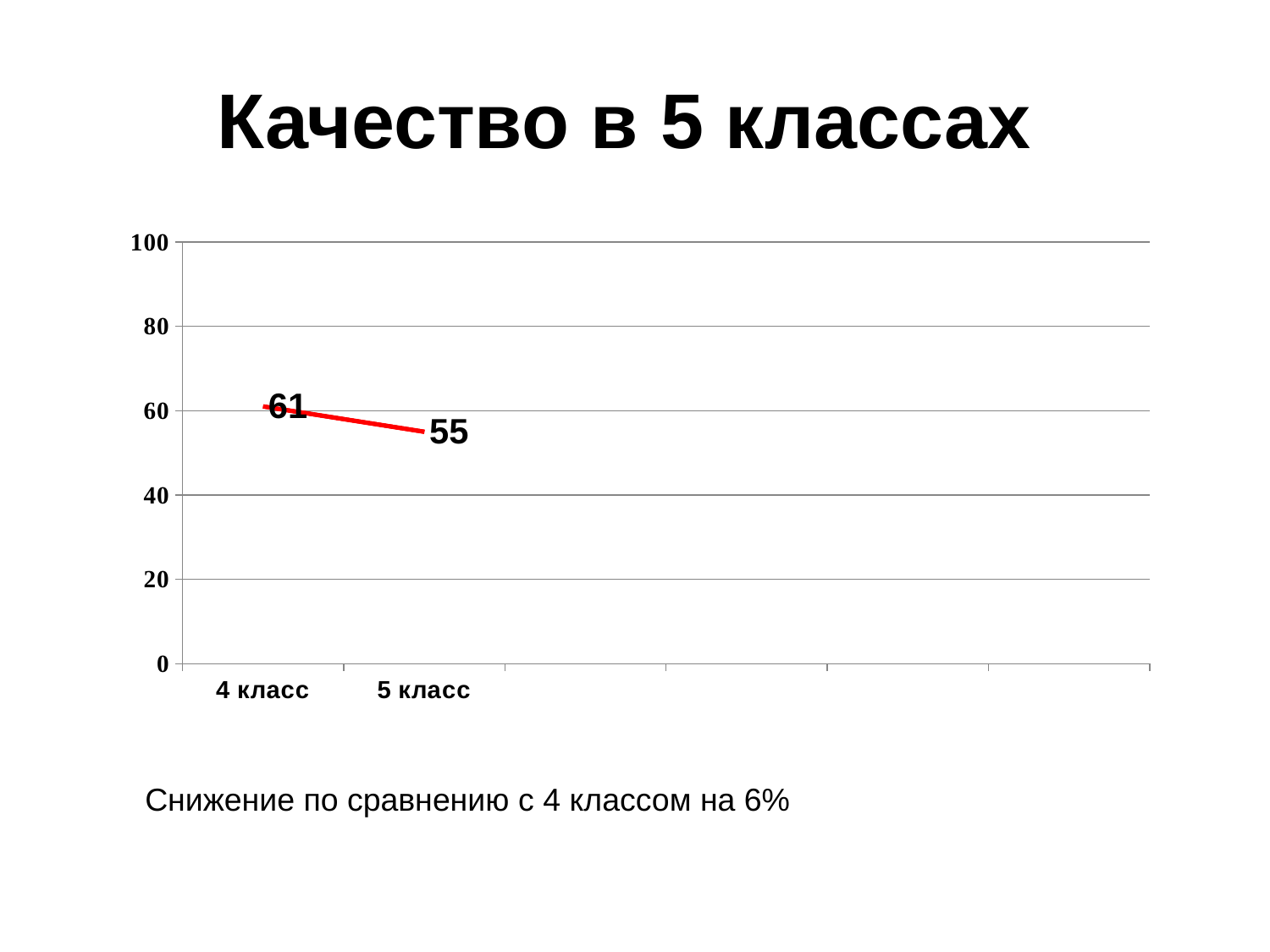
What is the value for 5 класс? 55 Which category has the highest value? 4 класс What is the difference between the values for 4 класс and 5 класс? 6 What is the value for 4 класс? 61 Is the value for 5 класс greater or less than 60? less Do the values rise or fall from 4 класс to 5 класс? fall Is the value for 4 класс greater or less than 40? greater Which category has the lowest value? 5 класс How many data points are plotted on the chart? 2 What is the title of the slide? Качество в 5 классах What kind of chart is shown on the slide? line chart Which is larger, the value for 4 класс or the value for 5 класс? 4 класс